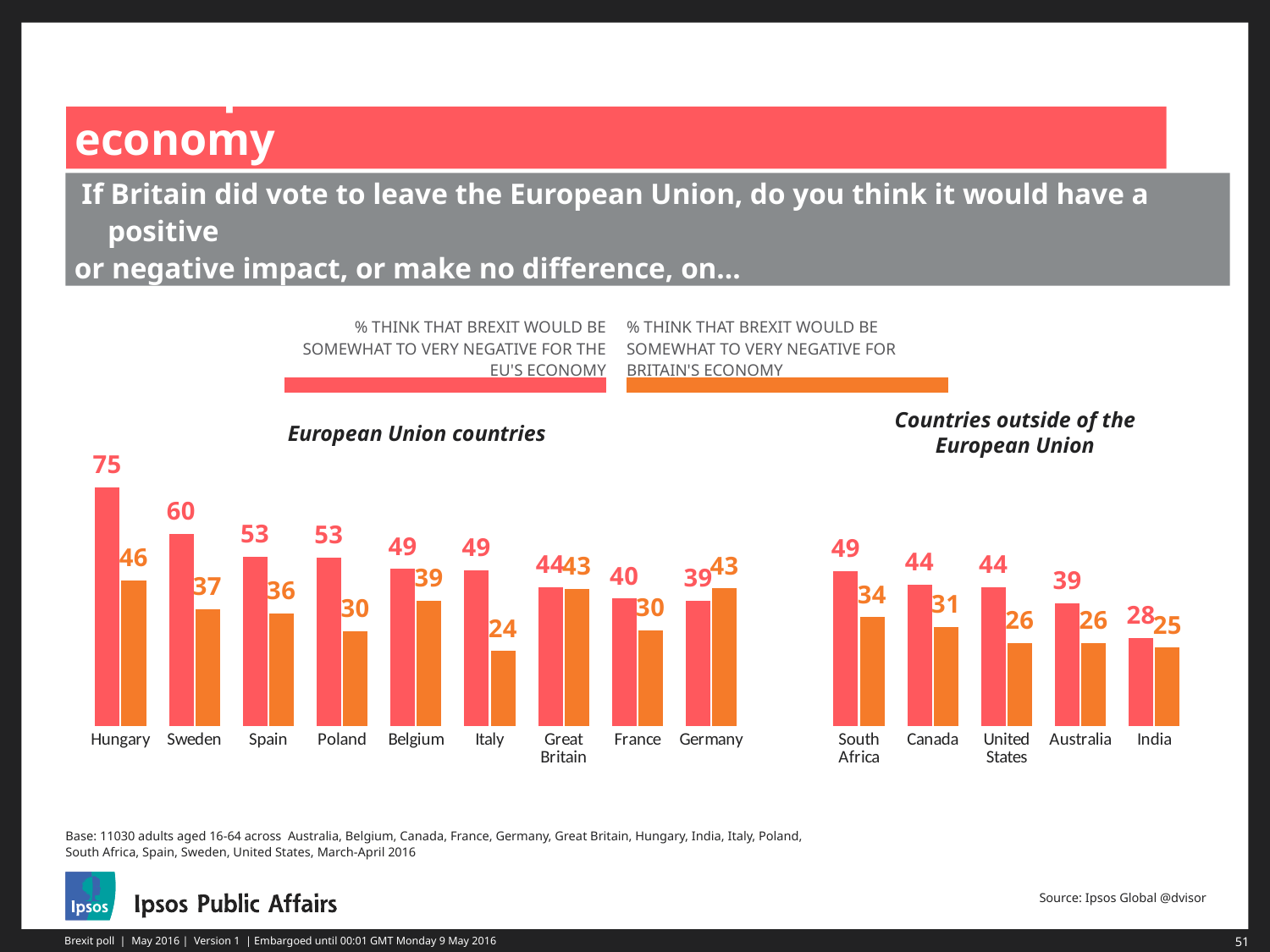
How many countries are shown in the 'European Union countries' chart? 9 What type of chart is used on this slide? Bar chart In the 'European Union countries' chart, which is larger for Germany: the value for the EU's economy or the value for Britain's economy? Britain's economy In the 'Countries outside of the European Union' chart, what is the difference between the two values for the United States? 18 In the 'European Union countries' chart, what percentage in Italy think Brexit would be negative for Britain's economy? 24 In the 'Countries outside of the European Union' chart, what percentage in Canada think Brexit would be negative for Britain's economy? 31 In the 'European Union countries' chart, which country has the lowest value for Brexit being negative for Britain's economy? Italy In the 'European Union countries' chart, what is the difference between Hungary's two values? 29 In the 'European Union countries' chart, which country has the highest value for Brexit being negative for the EU's economy? Hungary In the 'Countries outside of the European Union' chart, which country has the lowest value for Brexit being negative for the EU's economy? India In the 'European Union countries' chart, what percentage in Hungary think Brexit would be negative for the EU's economy? 75 How many countries are shown in the 'Countries outside of the European Union' chart? 5